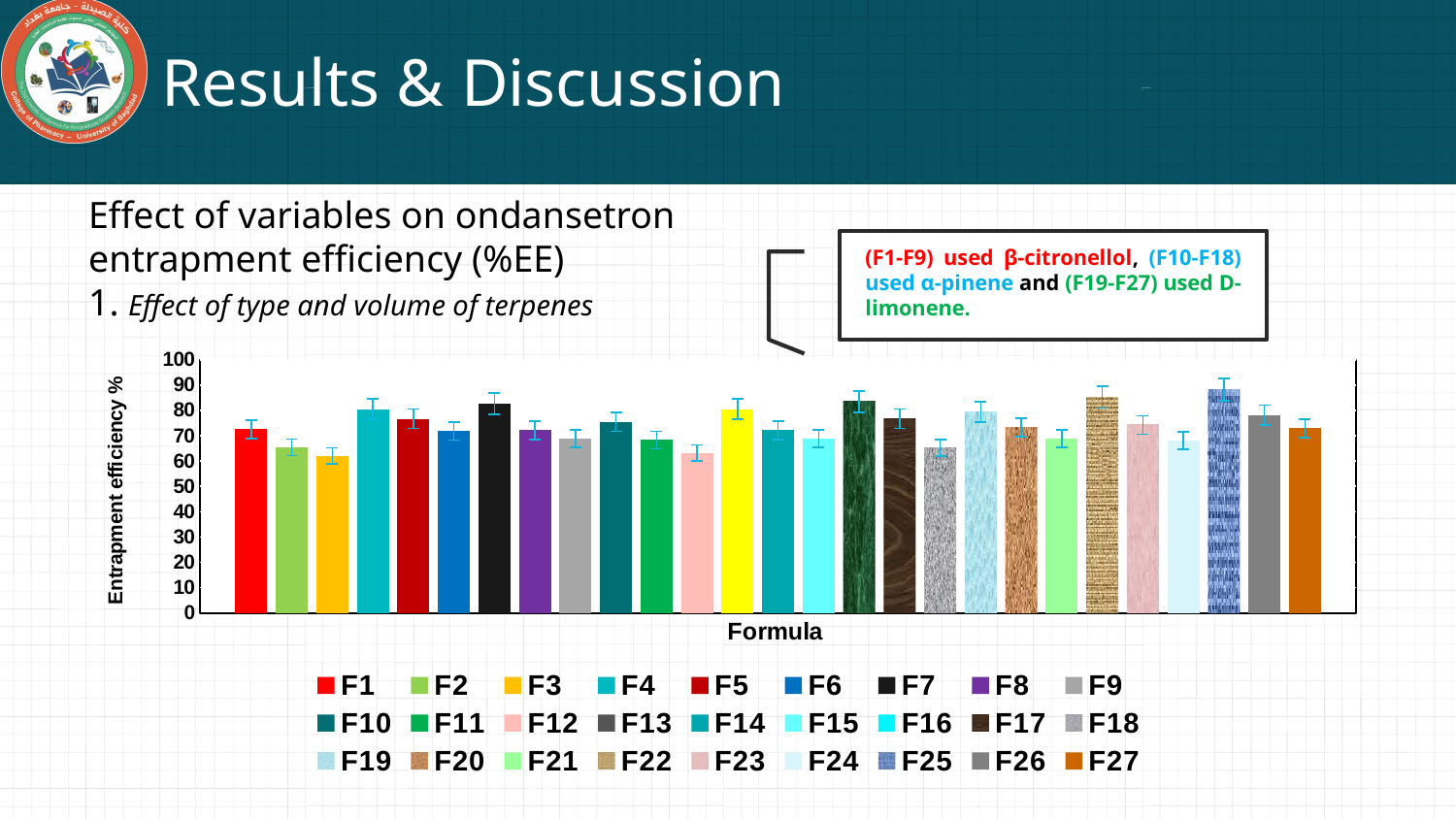
Which formula has the highest entrapment efficiency in the chart? F25 Is the entrapment efficiency for F3 greater or less than 70? less What is the label of the vertical axis of the chart? Entrapment efficiency % Which has the higher entrapment efficiency, F7 or F3? F7 Is the entrapment efficiency for F22 greater or less than 80? greater How many entries does the chart legend list? 27 Is the entrapment efficiency for F12 greater or less than 70? less How many formula bars are plotted in the chart? 27 Which has the higher entrapment efficiency, F16 or F12? F16 What kind of chart is shown on the slide? bar chart What is the label of the horizontal axis of the chart? Formula